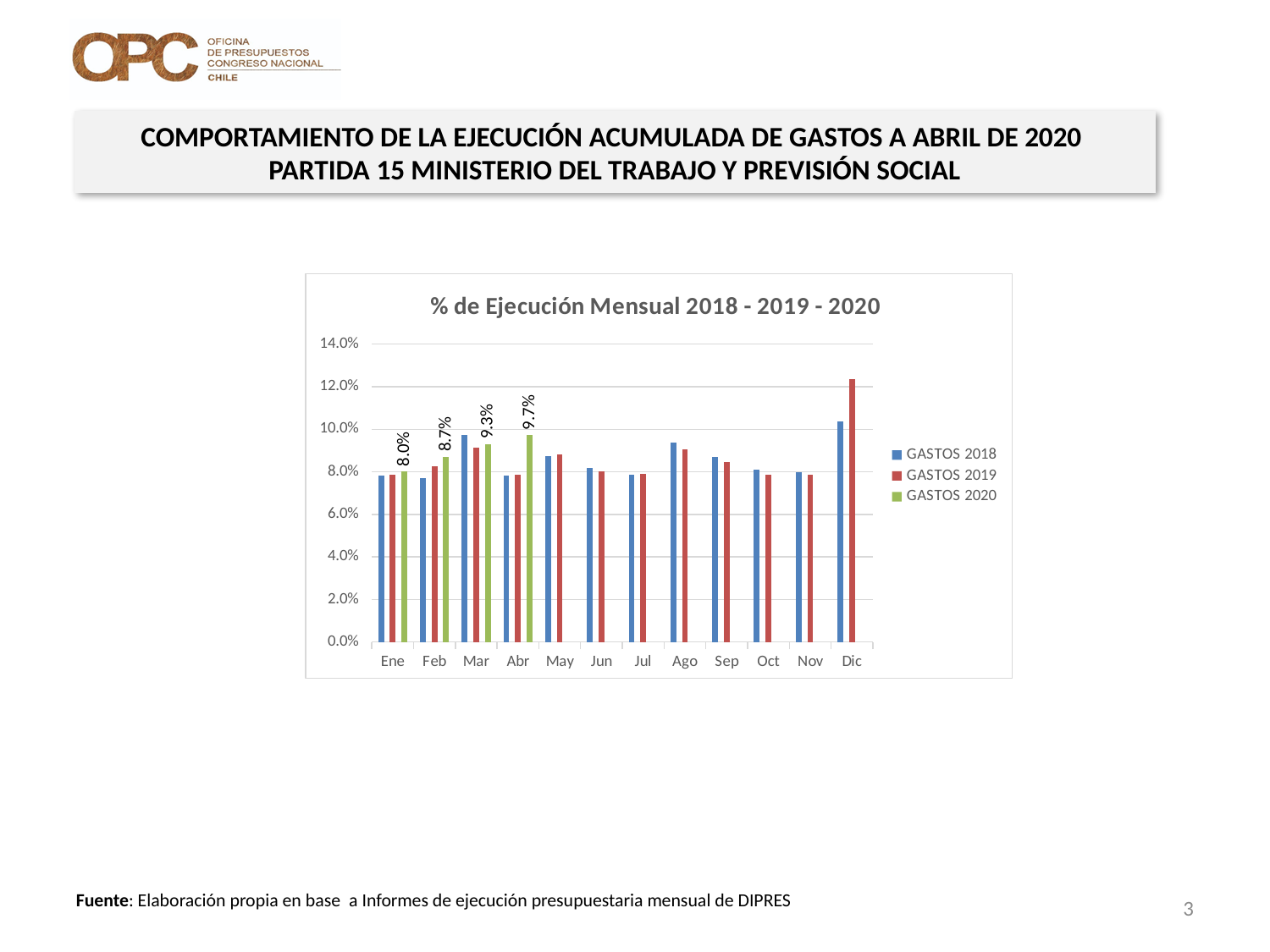
What is the difference between the GASTOS 2020 values for Abr and Ene? 1.7 percentage points What is the value for GASTOS 2020 in Ene? 8.0% What is the value for GASTOS 2020 in Mar? 9.3% Which month has the highest value for GASTOS 2019? Dic What is the value for GASTOS 2020 in Abr? 9.7% Which month has the highest value for GASTOS 2020? Abr Do the GASTOS 2020 values rise or fall from Ene to Abr? rise In Dic, which is larger: GASTOS 2018 or GASTOS 2019? GASTOS 2019 How many series does the legend list? 3 Is the value for GASTOS 2019 in Dic greater or less than 12.0%? greater Is the value for GASTOS 2018 in Dic greater or less than 10.0%? greater How many months are shown on the x axis? 12